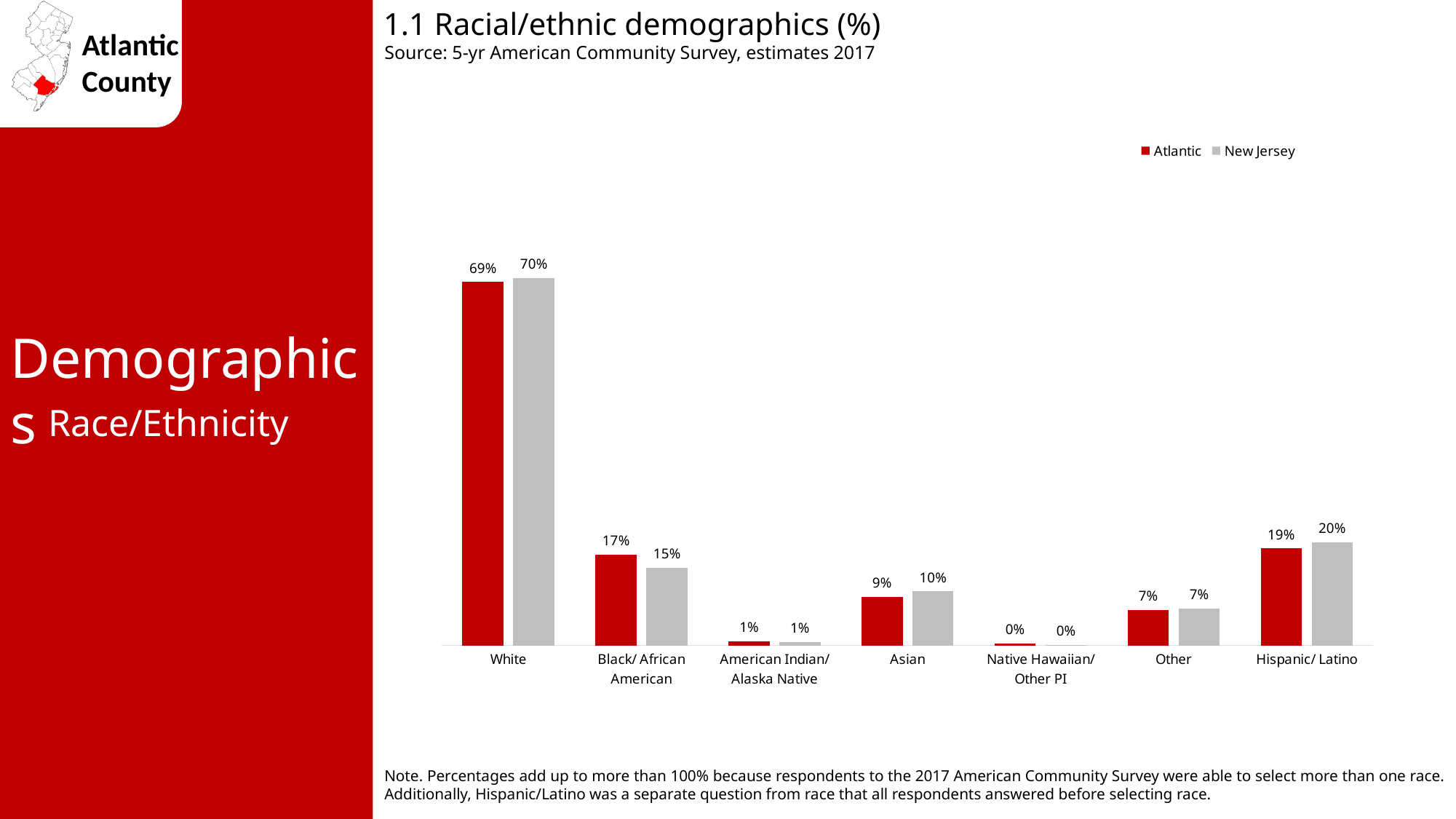
How many series does the legend list? 2 Which is larger for Hispanic/ Latino, the Atlantic value or the New Jersey value? New Jersey Which category has the highest Atlantic value? White What is the New Jersey value for Asian? 10% What is the difference between the Atlantic and New Jersey values for Black/ African American? 2% What kind of chart is shown on the slide? Bar chart What colour are the Atlantic bars? Red What is the Atlantic value for Hispanic/ Latino? 19% What is the Atlantic value for White? 69% How many categories are shown on the x axis? 7 Which category has the lowest New Jersey value? Native Hawaiian/ Other PI What is the New Jersey value for Black/ African American? 15%